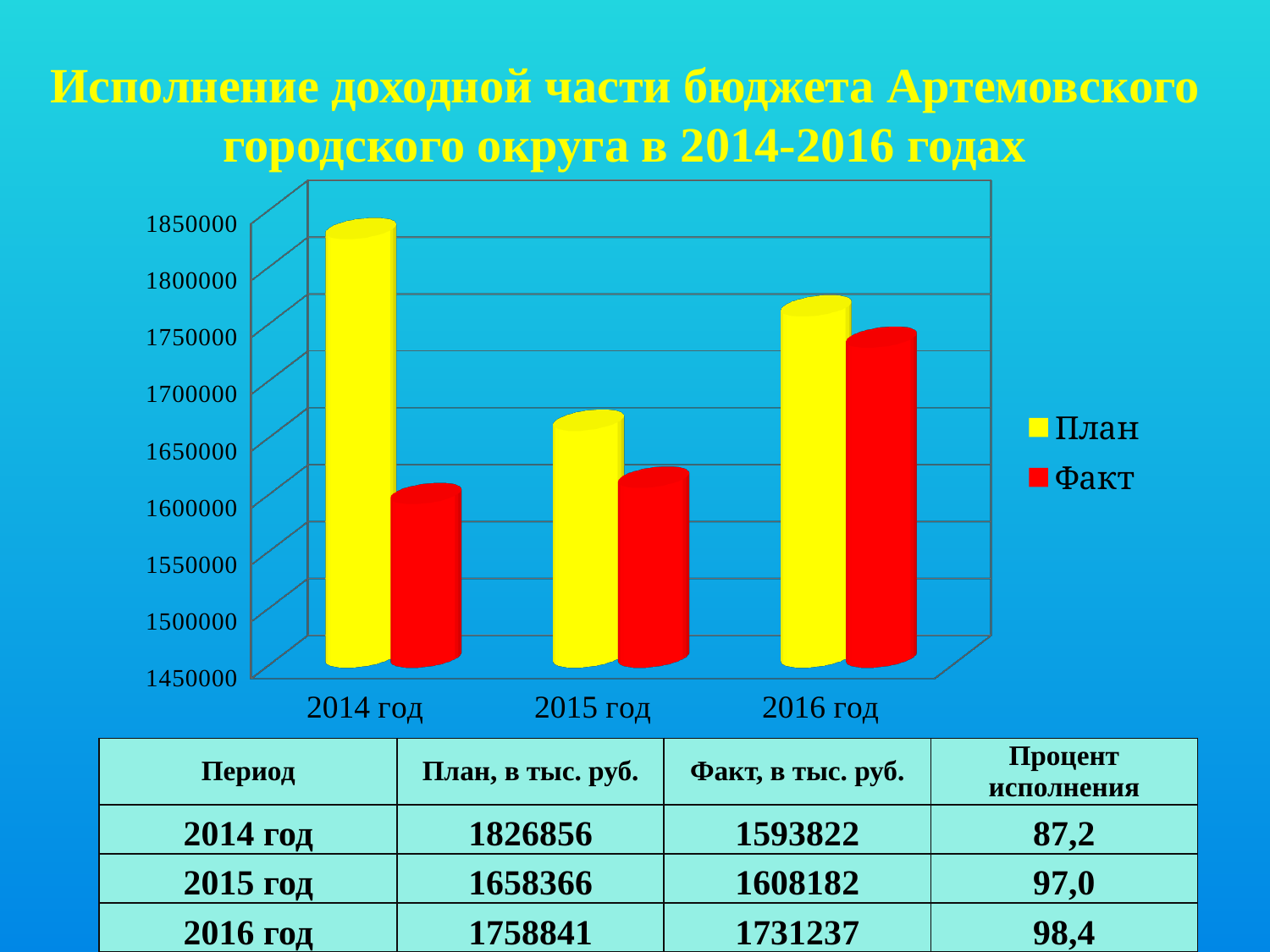
How many series does the chart legend list? 2 What kind of chart is shown on the slide? bar chart Which is larger in 2014 год, План or Факт? План What is the Факт value for 2016 год? 1731237 Which year has the lowest Факт value? 2014 год How many year categories are shown on the x axis of the chart? 3 Is the План value for 2015 год greater or less than 1700000? less What is the План value for 2014 год? 1826856 Is the Факт value for 2016 год greater or less than 1700000? greater What is the difference between План and Факт for 2015 год? 50184 Which year has the highest План value? 2014 год Which colour represents the Факт series in the chart? red